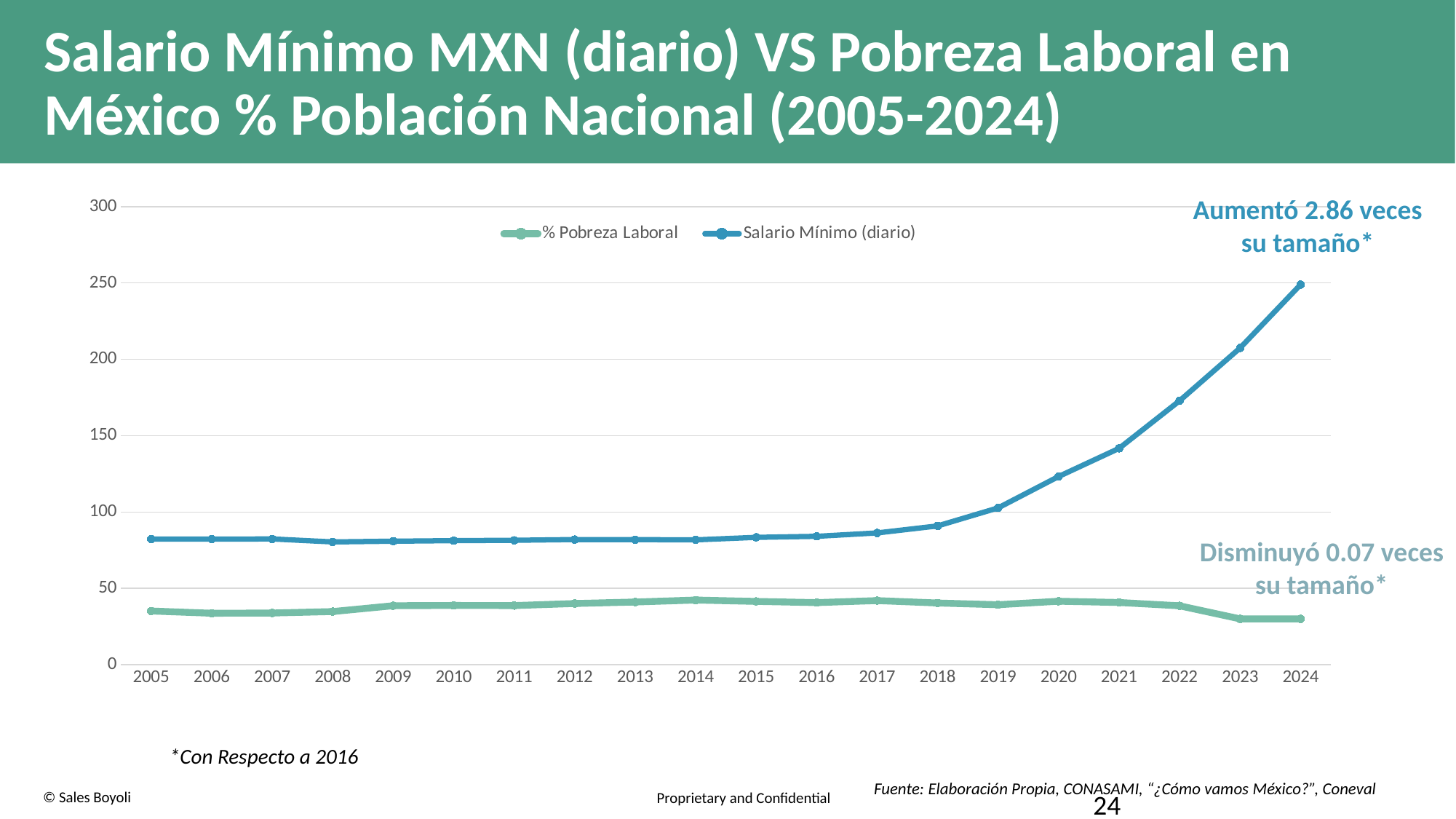
Is the value for Salario Mínimo (diario) in 2005 greater or less than 100? less Is the value for Salario Mínimo (diario) in 2021 greater or less than 150? less Is the value for % Pobreza Laboral in 2024 greater or less than 50? less Does the % Pobreza Laboral series rise or fall from 2021 to 2024? fall Does the Salario Mínimo (diario) series rise or fall from 2016 to 2024? rise According to the annotation on the chart, by how many times did the Salario Mínimo increase in size? 2.86 veces How many years are plotted along the x axis? 20 How many series does the legend list? 2 Which series has the larger value in 2016, % Pobreza Laboral or Salario Mínimo (diario)? Salario Mínimo (diario) What kind of chart is shown on the slide? line chart Which year has the highest value for Salario Mínimo (diario)? 2024